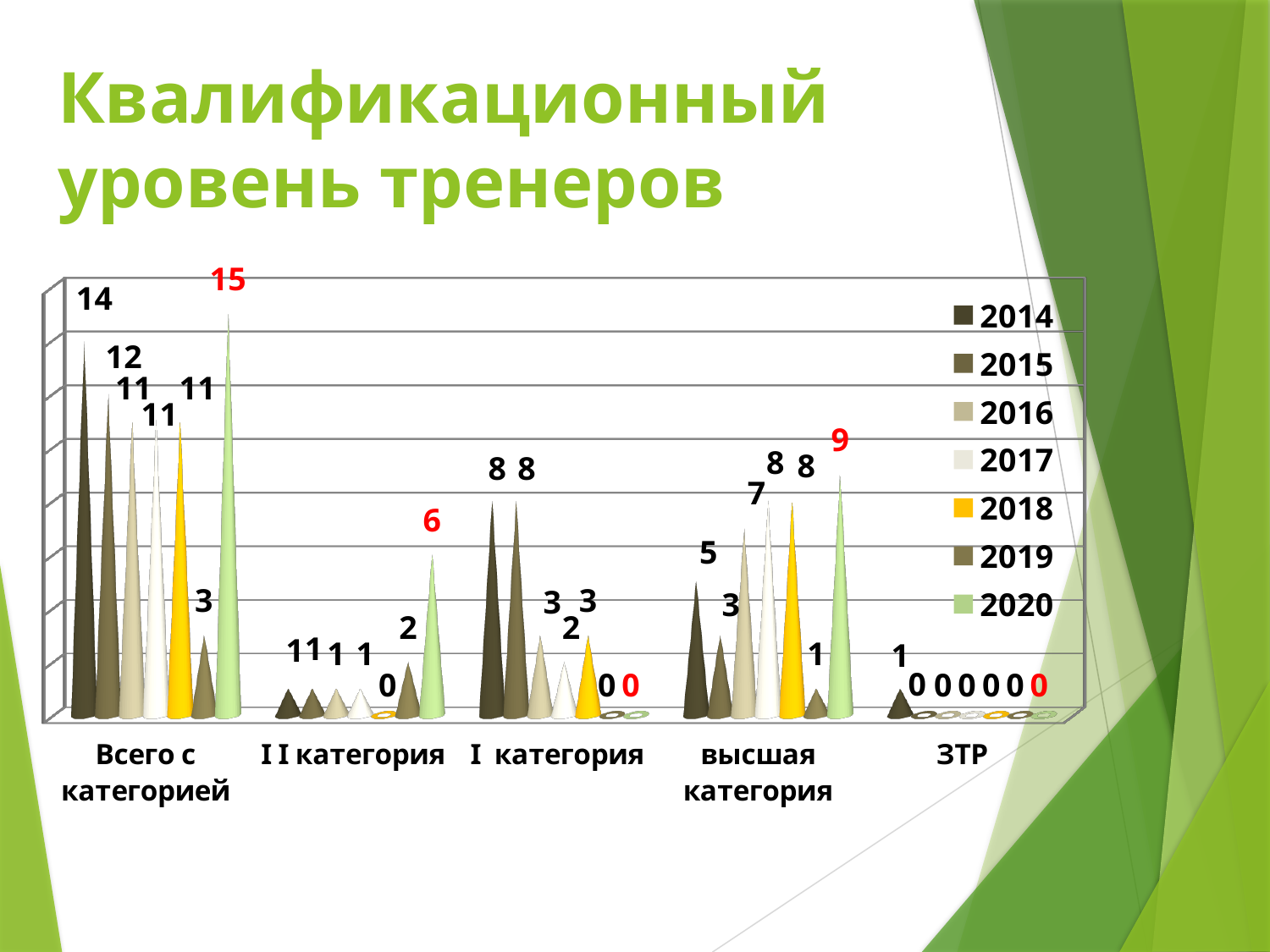
What kind of chart is shown on the slide? Bar chart What is the value for 2020 in the 'II категория' category? 6 Which year has the highest value in the 'высшая категория' category? 2020 In the 'I категория' category, which is larger: the value for 2014 or the value for 2016? 2014 Which year has the lowest value in the 'Всего с категорией' category? 2019 How many categories are shown on the x axis? 5 What is the value for 2014 in the 'Всего с категорией' category? 14 What is the value for 2020 in the 'Всего с категорией' category? 15 What is the difference between the 2020 and 2014 values in the 'Всего с категорией' category? 1 How many series does the legend list? 7 What is the value for 2019 in the 'Всего с категорией' category? 3 What is the title of the slide? Квалификационный уровень тренеров